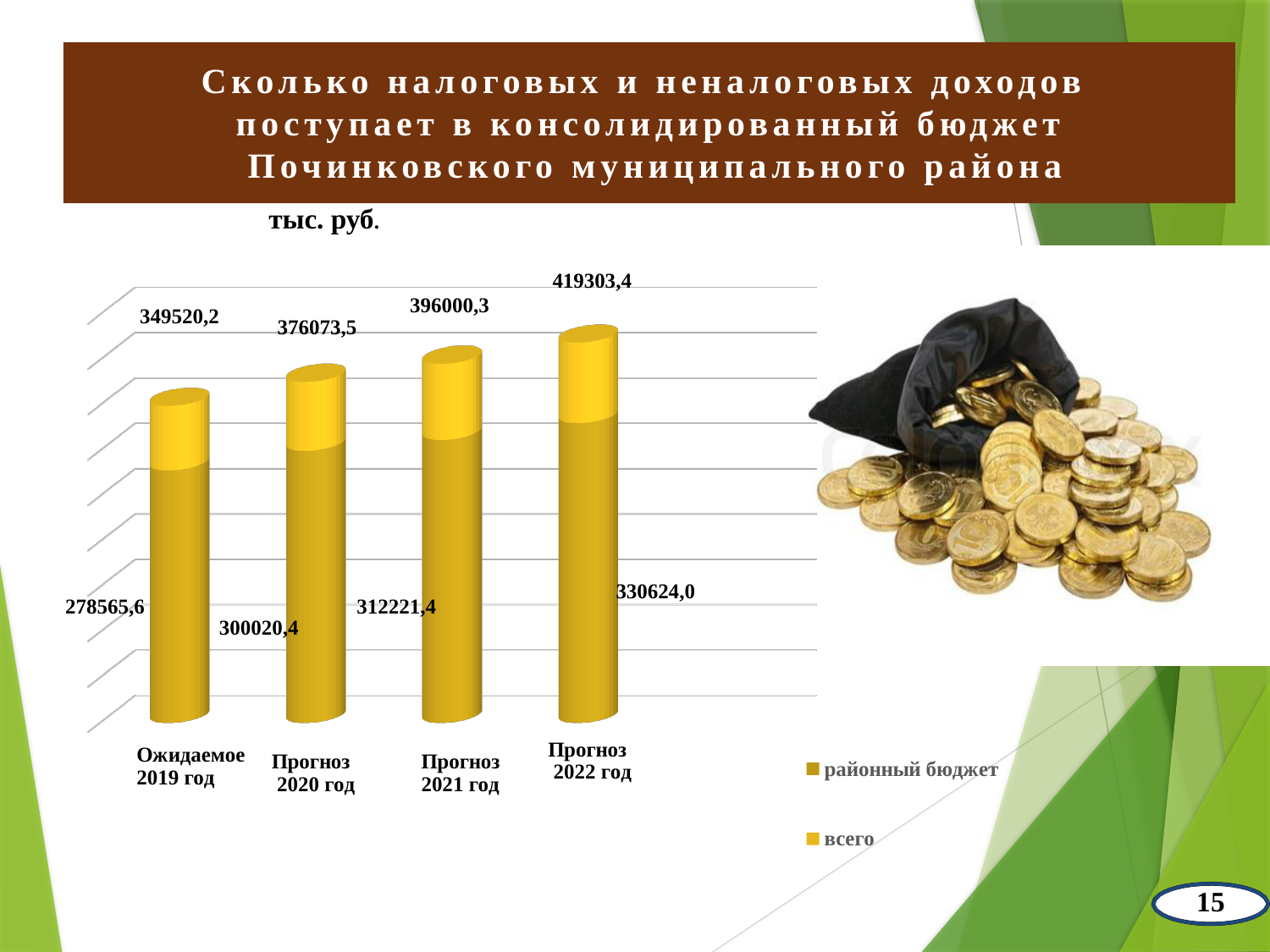
What unit is stated above the chart? тыс. руб. How many series does the legend list? 2 What is the difference between "всего" and "районный бюджет" for Прогноз 2022 год? 88679,4 What is the value of "районный бюджет" for Прогноз 2020 год? 300020,4 Which category has the highest value for "всего"? Прогноз 2022 год Which category has the lowest value for "районный бюджет"? Ожидаемое 2019 год What is the value of "всего" for Прогноз 2022 год? 419303,4 What is the value of "всего" for Ожидаемое 2019 год? 349520,2 What type of chart is shown on the slide? bar chart What is the value of "районный бюджет" for Прогноз 2021 год? 312221,4 How many categories (years) are shown on the x axis? 4 Do the values of "всего" rise or fall from 2019 to 2022? rise